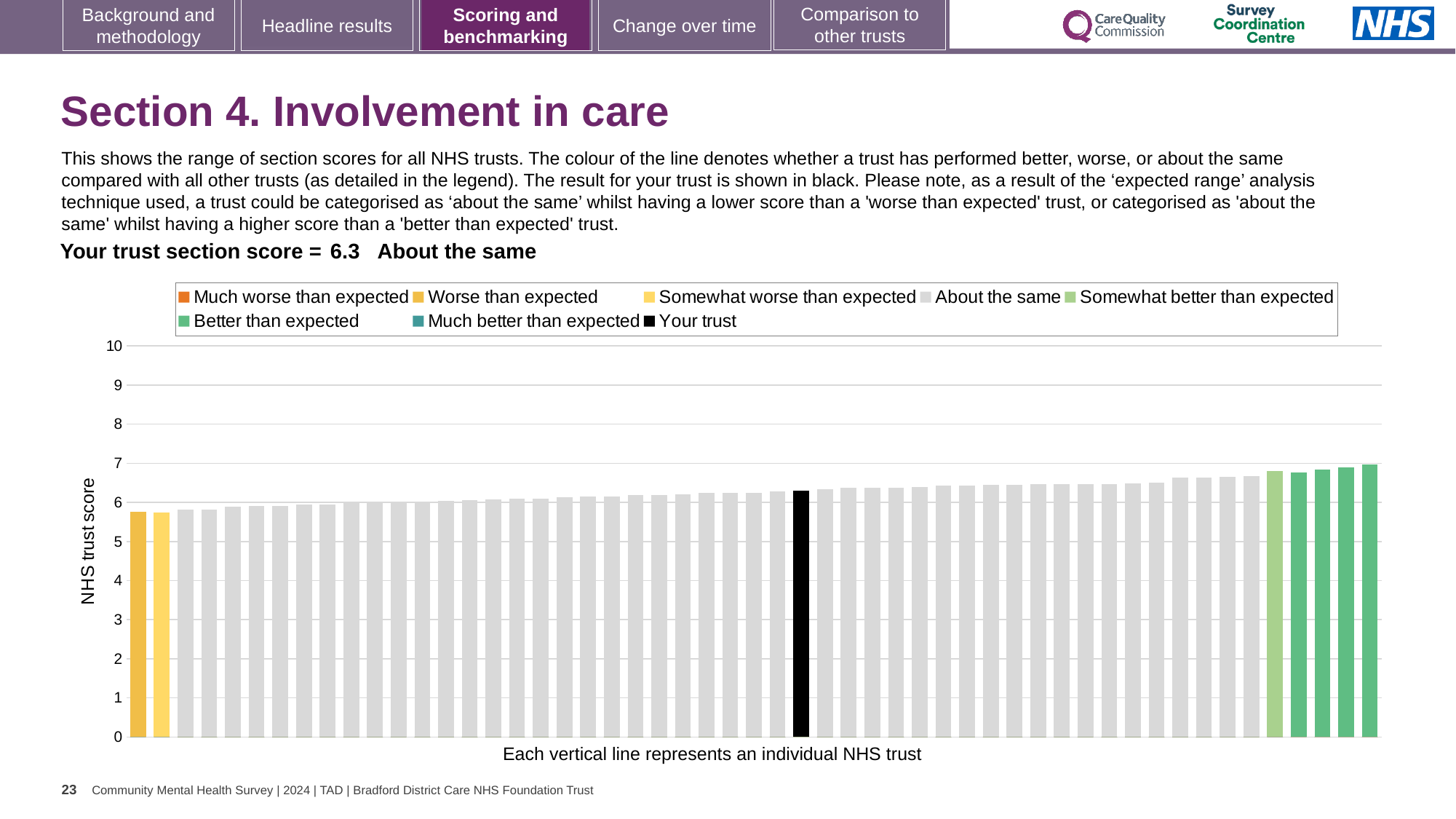
What category is your trust placed in for this section? About the same Is the value for your trust greater or less than 6? greater What is the label on the y axis of the chart? NHS trust score How many entries does the chart legend list? 8 Is the value for your trust greater or less than 7? less How many bars are coloured as 'Better than expected' (dark green)? 4 What is the section score for your trust shown on the slide? 6.3 What kind of chart is shown on the slide? bar chart Is the highest bar on the chart greater or less than 8? less Do the bar values rise or fall from left to right along the x axis? rise How many bars are coloured as 'Worse than expected' (yellow)? 1